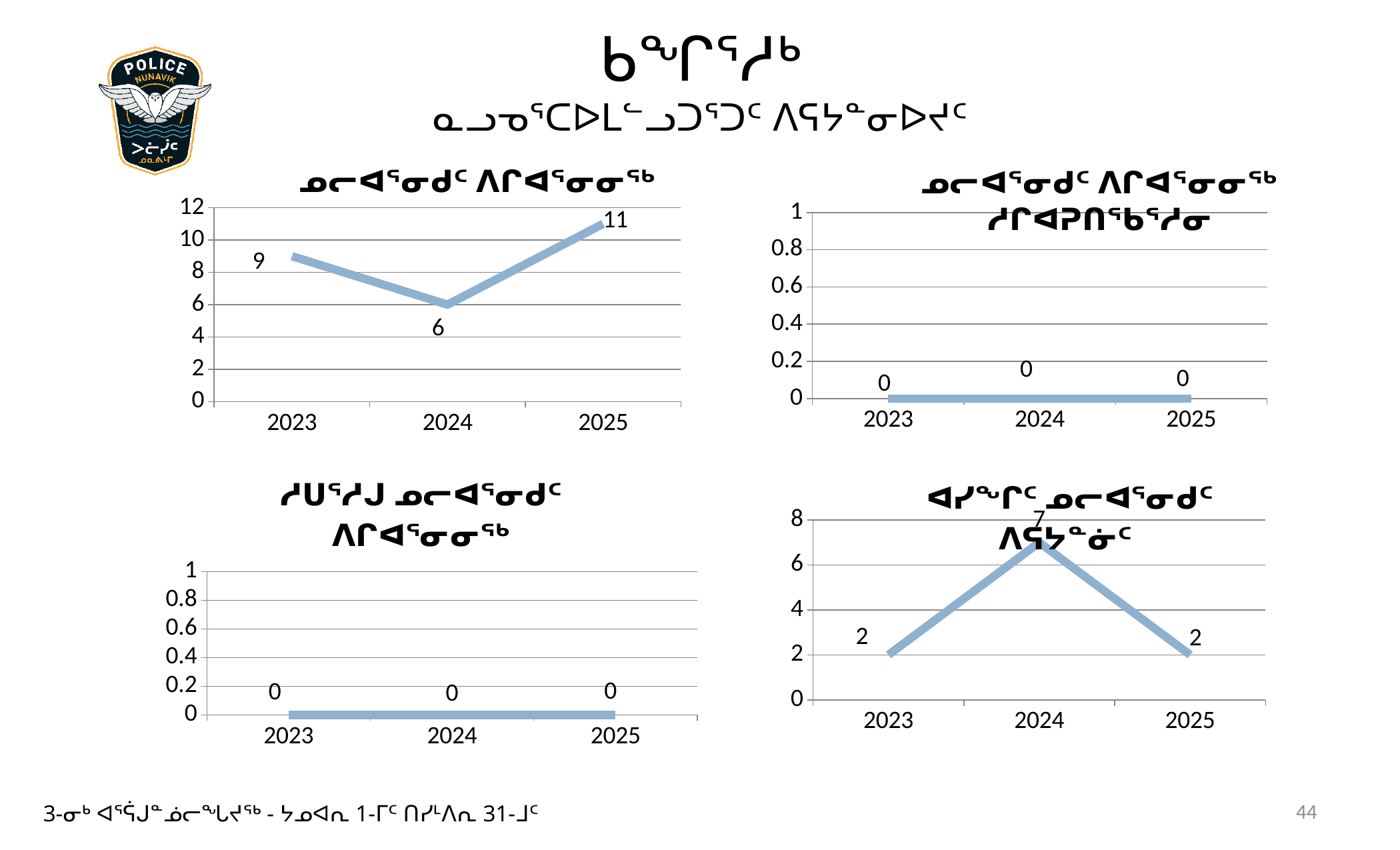
In the top-left chart, what is the difference between the values for 2025 and 2024? 5 In the bottom-left chart, how many years are plotted on the x axis? 3 In the top-left chart, is the value for 2025 greater or less than 10? greater In the bottom-right chart, what is the value for 2025? 2 In the top-right chart, what is the value for 2024? 0 In the top-left chart, which year has the highest value? 2025 In the top-left chart, what is the value for 2024? 6 In the top-left chart, which year has the lowest value? 2024 In the bottom-right chart, what is the value for 2024? 7 In the bottom-right chart, which year has the highest value? 2024 In the top-left chart, what is the value for 2023? 9 What kind of chart is the bottom-right chart? line chart